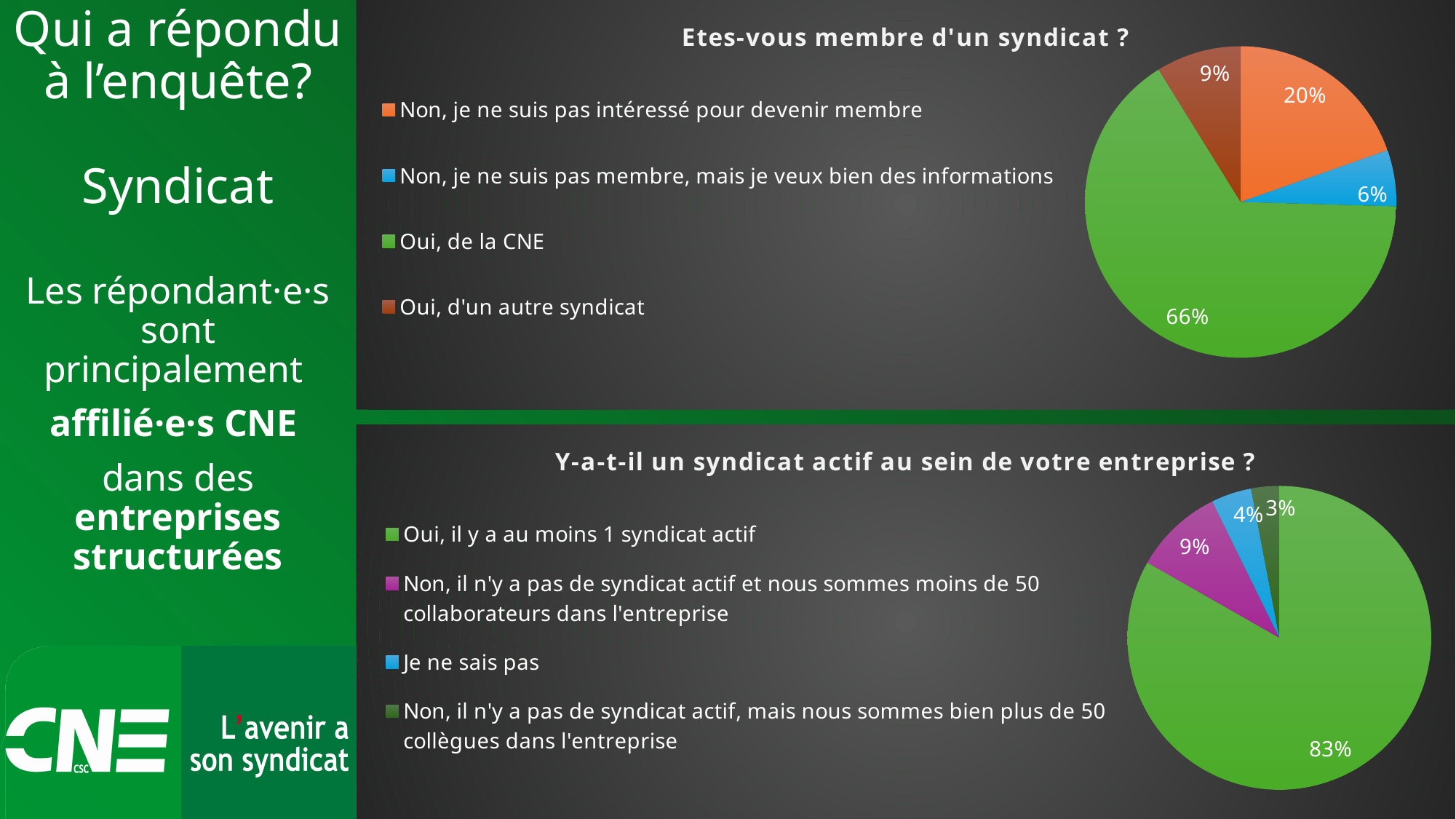
In the chart titled "Y-a-t-il un syndicat actif au sein de votre entreprise ?", what share of respondents answered "Oui, il y a au moins 1 syndicat actif"? 83% What kind of chart is the chart titled "Y-a-t-il un syndicat actif au sein de votre entreprise ?"? Pie chart In the chart titled "Y-a-t-il un syndicat actif au sein de votre entreprise ?", what share of respondents answered "Je ne sais pas"? 4% In the chart titled "Etes-vous membre d'un syndicat ?", what share of respondents answered "Oui, d'un autre syndicat"? 9% In the chart titled "Y-a-t-il un syndicat actif au sein de votre entreprise ?", which category has the largest slice? Oui, il y a au moins 1 syndicat actif In the chart titled "Etes-vous membre d'un syndicat ?", what share of respondents answered "Non, je ne suis pas intéressé pour devenir membre"? 20% In the chart titled "Y-a-t-il un syndicat actif au sein de votre entreprise ?", what colour is the slice for "Je ne sais pas"? Blue In the chart titled "Etes-vous membre d'un syndicat ?", what share of respondents answered "Oui, de la CNE"? 66% In the chart titled "Etes-vous membre d'un syndicat ?", which category has the smallest slice? Non, je ne suis pas membre, mais je veux bien des informations In the chart titled "Etes-vous membre d'un syndicat ?", how many categories does the legend list? 4 In the chart titled "Etes-vous membre d'un syndicat ?", what is the difference between the "Oui, de la CNE" slice and the "Non, je ne suis pas intéressé pour devenir membre" slice? 46% In the chart titled "Y-a-t-il un syndicat actif au sein de votre entreprise ?", which is larger: the slice for "Non, il n'y a pas de syndicat actif et nous sommes moins de 50 collaborateurs dans l'entreprise" or the slice for "Je ne sais pas"? Non, il n'y a pas de syndicat actif et nous sommes moins de 50 collaborateurs dans l'entreprise